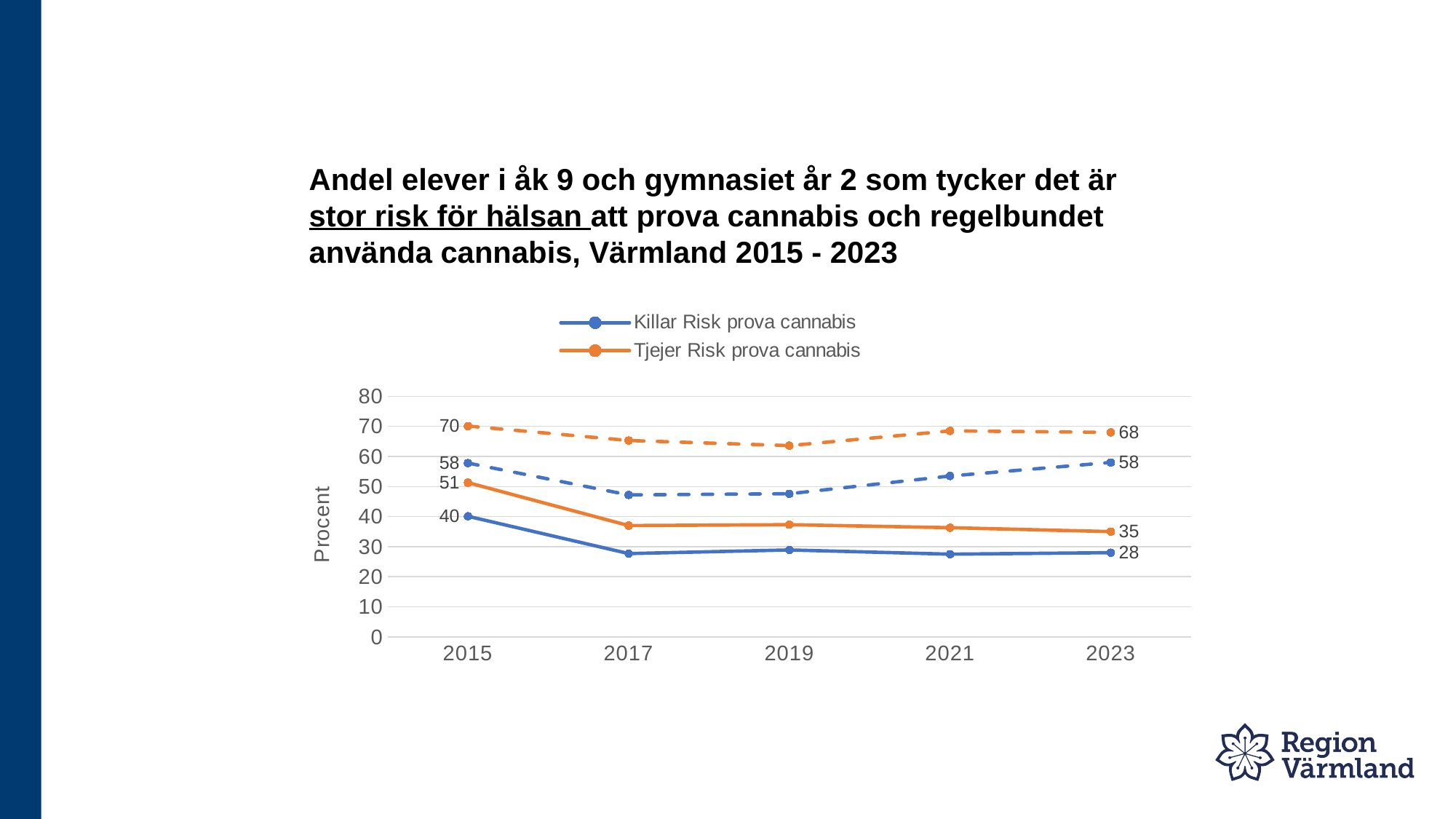
What kind of chart is shown on the slide? line chart What is the difference between the dashed orange line's values in 2015 and 2023? 2 What is the value of the solid blue line in 2023? 28 In 2023, which is larger: the solid orange line or the solid blue line? the solid orange line By how much did the solid orange line fall from 2015 to 2023? 16 How many years are shown on the x axis? 5 What is the value of the dashed orange line in 2015? 70 What is the value of the dashed blue line in 2023? 58 What is the label on the y axis? Procent What is the value of the solid orange line in 2015? 51 How many series does the legend list? 2 Is the value of the dashed blue line in 2017 greater or less than 50? less